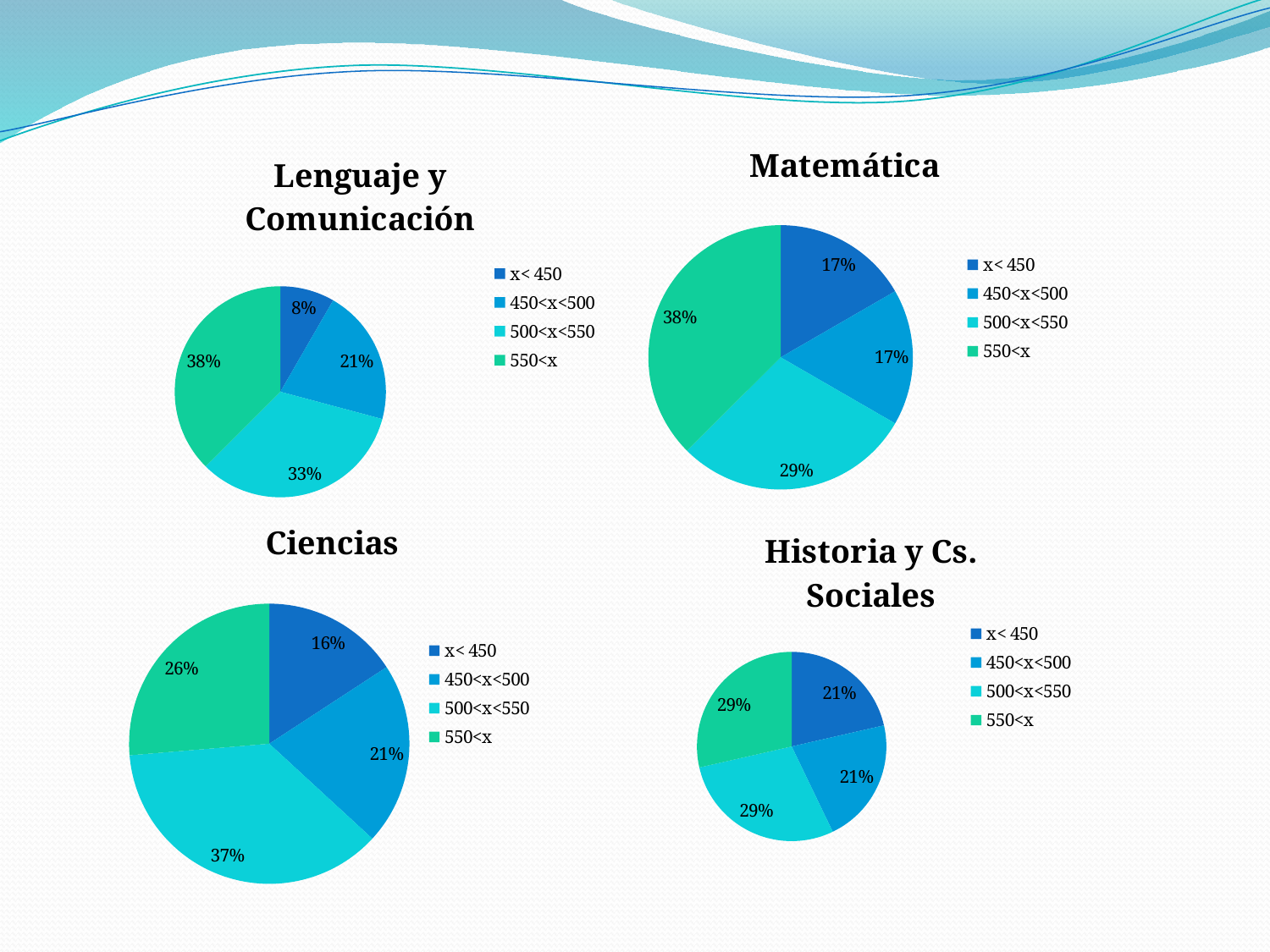
In the Ciencias chart, which category has the largest slice? 500<x<550 In the Matemática chart, what share does the 500<x<550 slice have? 29% What kind of chart is the Ciencias chart? Pie chart How many series does the legend of the Matemática chart list? 4 In the Lenguaje y Comunicación chart, what share does the x< 450 slice have? 8% In the Historia y Cs. Sociales chart, what is the difference between the 550<x slice and the x< 450 slice? 8% In the Historia y Cs. Sociales chart, what share does the 500<x<550 slice have? 29% In the Matemática chart, what is the difference between the 550<x slice and the x< 450 slice? 21% In the Ciencias chart, what share does the 550<x slice have? 26% In the Ciencias chart, which is larger: the 450<x<500 slice or the x< 450 slice? 450<x<500 In the Lenguaje y Comunicación chart, which category has the smallest slice? x< 450 In the Lenguaje y Comunicación chart, which category has the largest slice? 550<x